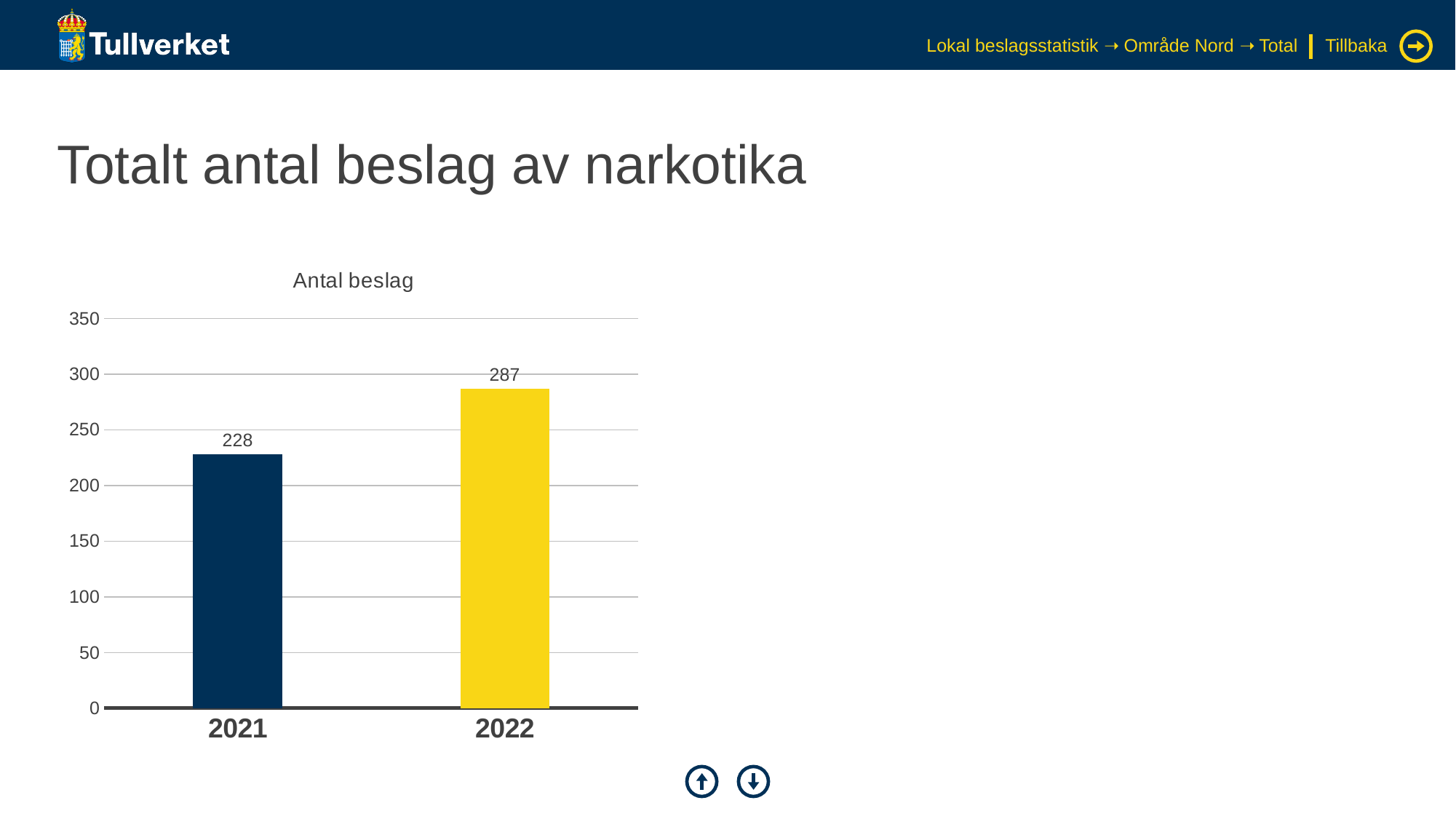
Is the value for 2022 greater or less than 250? greater What is the value for 2021? 228 Which is larger, the value for 2021 or the value for 2022? 2022 What is the value for 2022? 287 Do the values rise or fall from 2021 to 2022? rise Which year has the lowest value? 2021 What is the title of the chart? Antal beslag How many categories are shown on the x axis? 2 What kind of chart is shown? bar chart What is the difference between the values for 2022 and 2021? 59 Which year has the highest value? 2022 Is the value for 2021 greater or less than 250? less